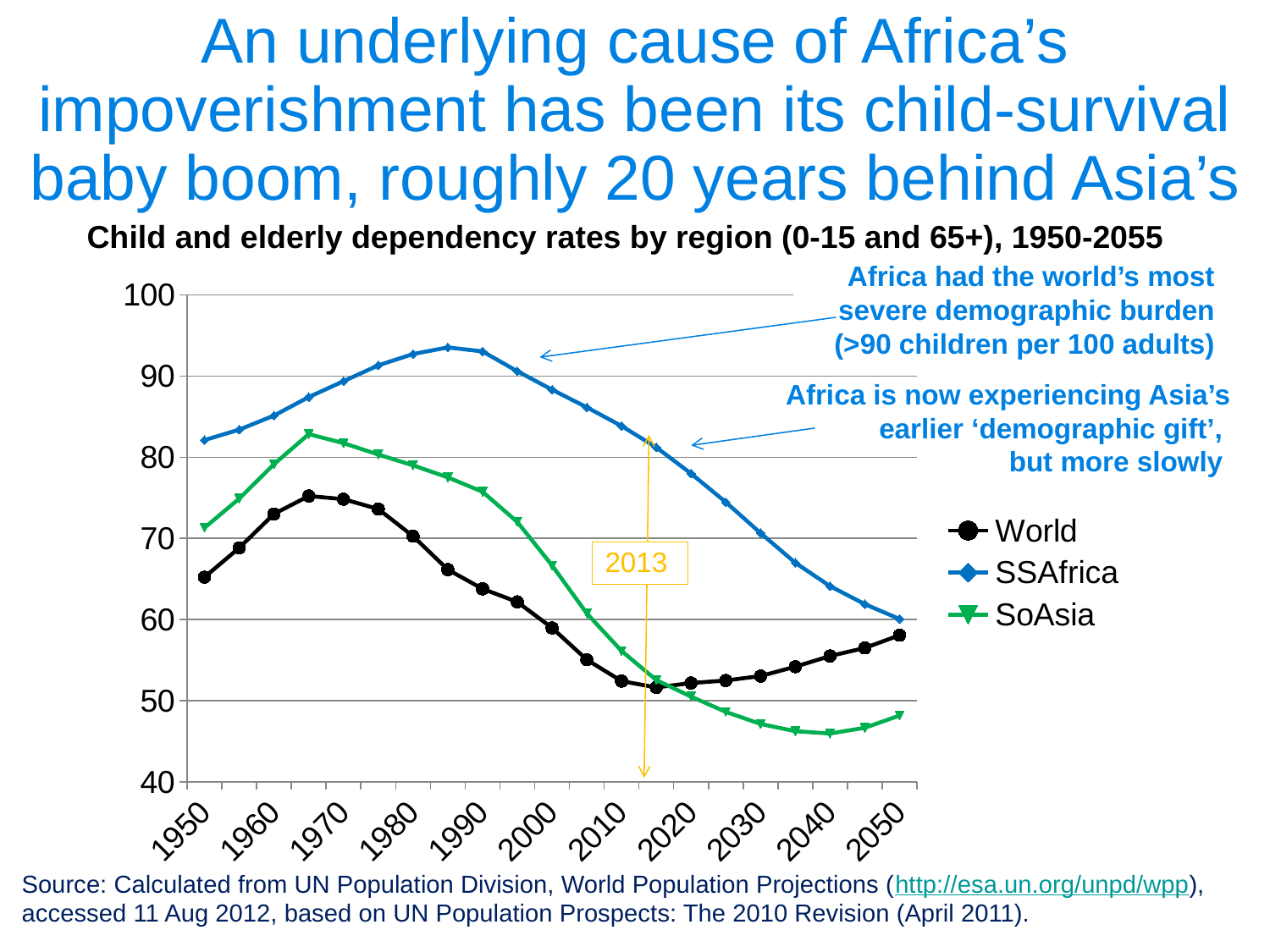
Which three series are listed in the chart's legend? World, SSAfrica, SoAsia Is the value for World in 1950 greater or less than 60? greater Which series has the highest values across the whole period shown? SSAfrica What kind of chart is shown on the slide? Line chart In 2050, which is higher, the World line or the SoAsia line? World Does the SSAfrica line rise or fall between 1990 and 2050? Fall Is the value for SoAsia in 2040 greater or less than 50? less What is the title of the chart? Child and elderly dependency rates by region (0-15 and 65+), 1950-2055 Does the World line rise or fall between 1950 and 1970? Rise How many series does the chart's legend list? 3 Is the peak value of the SSAfrica line greater or less than 90? greater